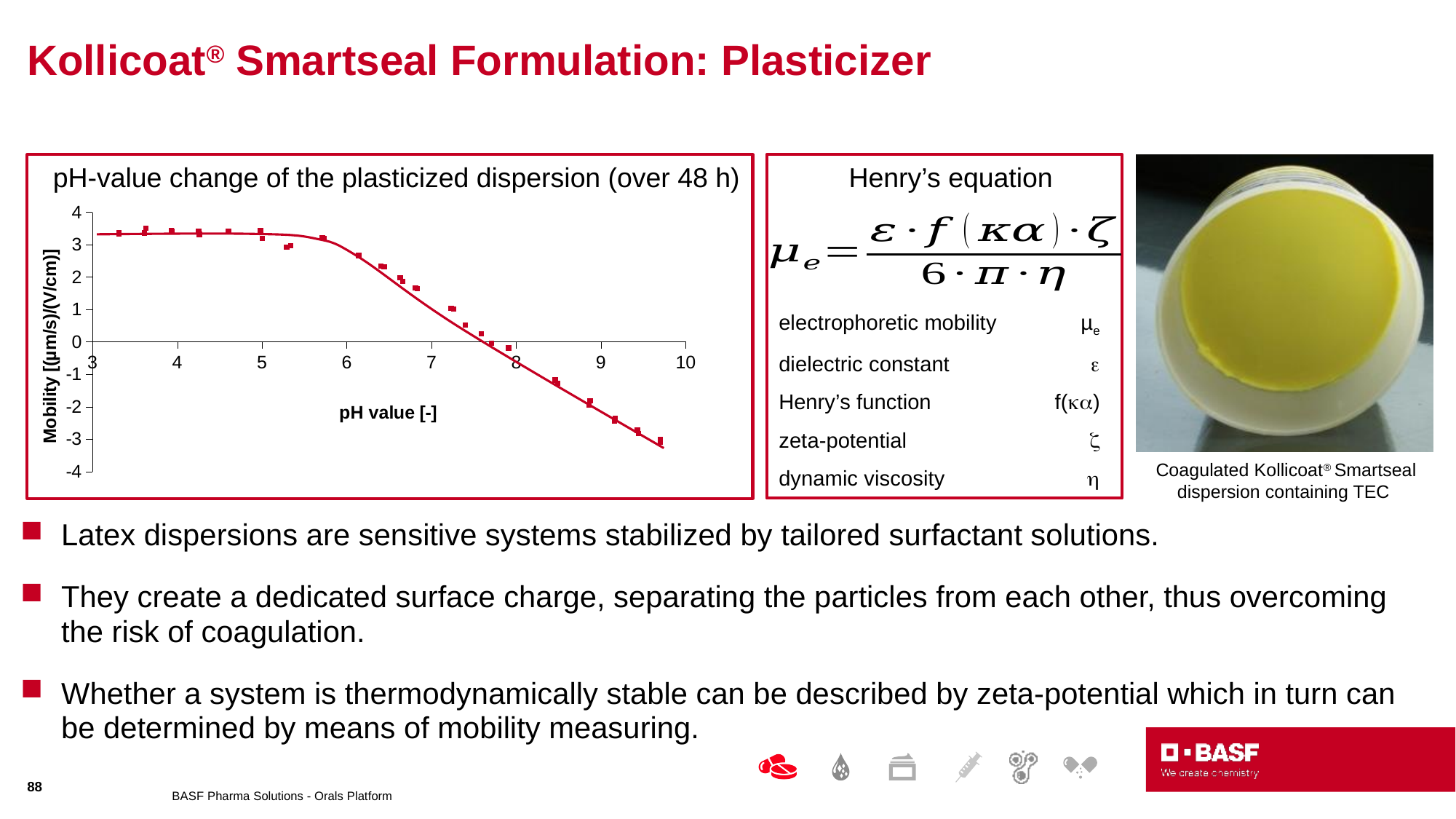
Is the mobility at pH 8.5 greater or less than 0? less What is the highest value shown on the y axis? 4 What is the title of the chart? pH-value change of the plasticized dispersion (over 48 h) What is the lowest pH value shown on the x axis? 3 As the pH value increases along the x axis, does the mobility rise or fall? Fall What kind of chart is shown on the slide? Scatter plot with a fitted line Which has the larger mobility: the point at pH 4 or the point at pH 9? pH 4 Is the mobility at pH 4 greater or less than 3? greater Is the mobility at pH 7 greater or less than 0? greater What quantity is plotted on the y axis of the chart? Mobility [(µm/s)/(V/cm)]